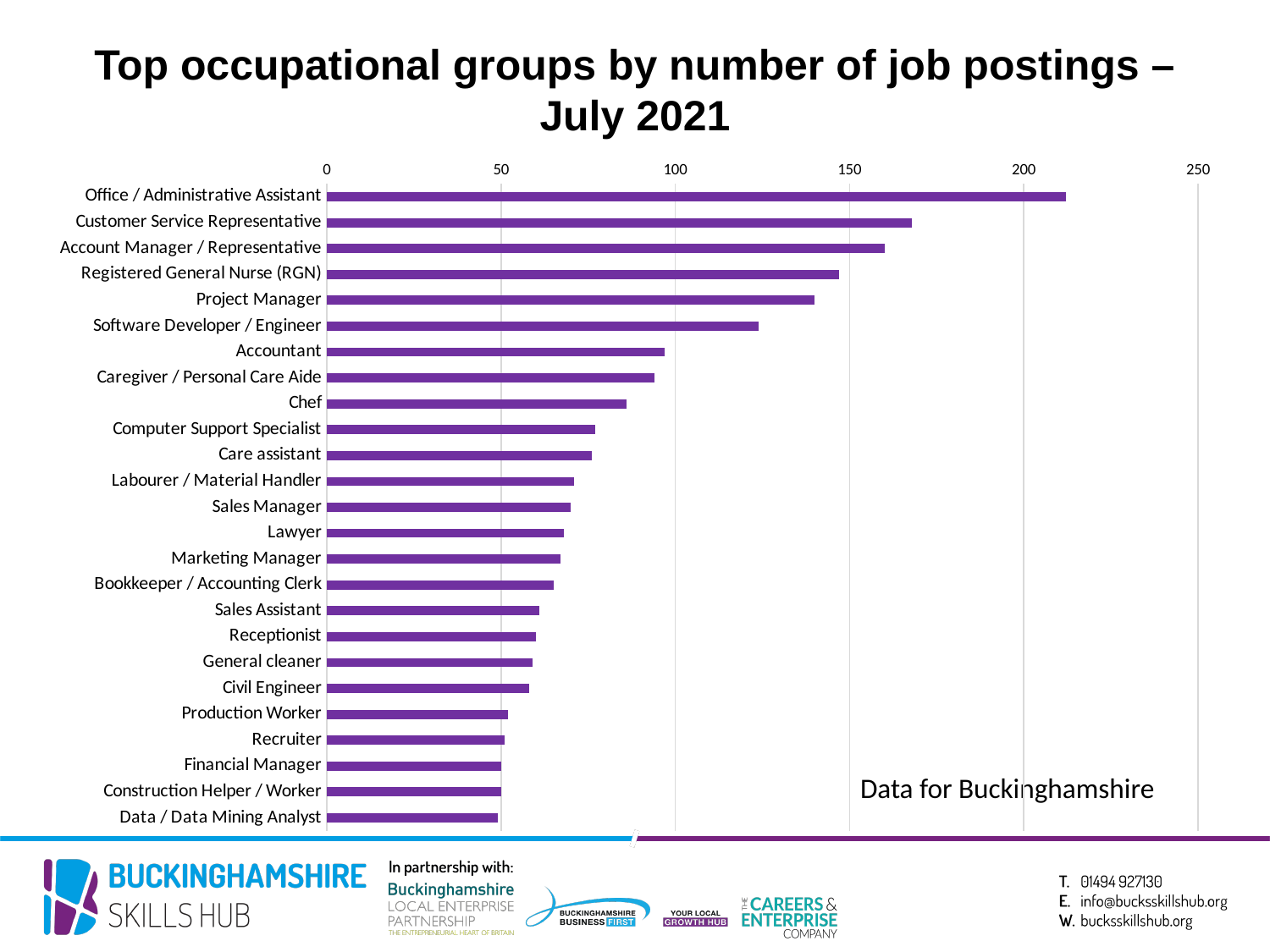
What kind of chart is shown on the slide? Bar chart Is the value for Software Developer / Engineer greater or less than 100? greater Is the value for Customer Service Representative greater or less than 150? greater Which has more job postings, Project Manager or Software Developer / Engineer? Project Manager Is the value for Office / Administrative Assistant greater or less than 200? greater Which occupational group has the highest number of job postings? Office / Administrative Assistant What is the title of the chart? Top occupational groups by number of job postings – July 2021 How many occupational groups are listed on the chart? 25 Which has more job postings, Accountant or Chef? Accountant